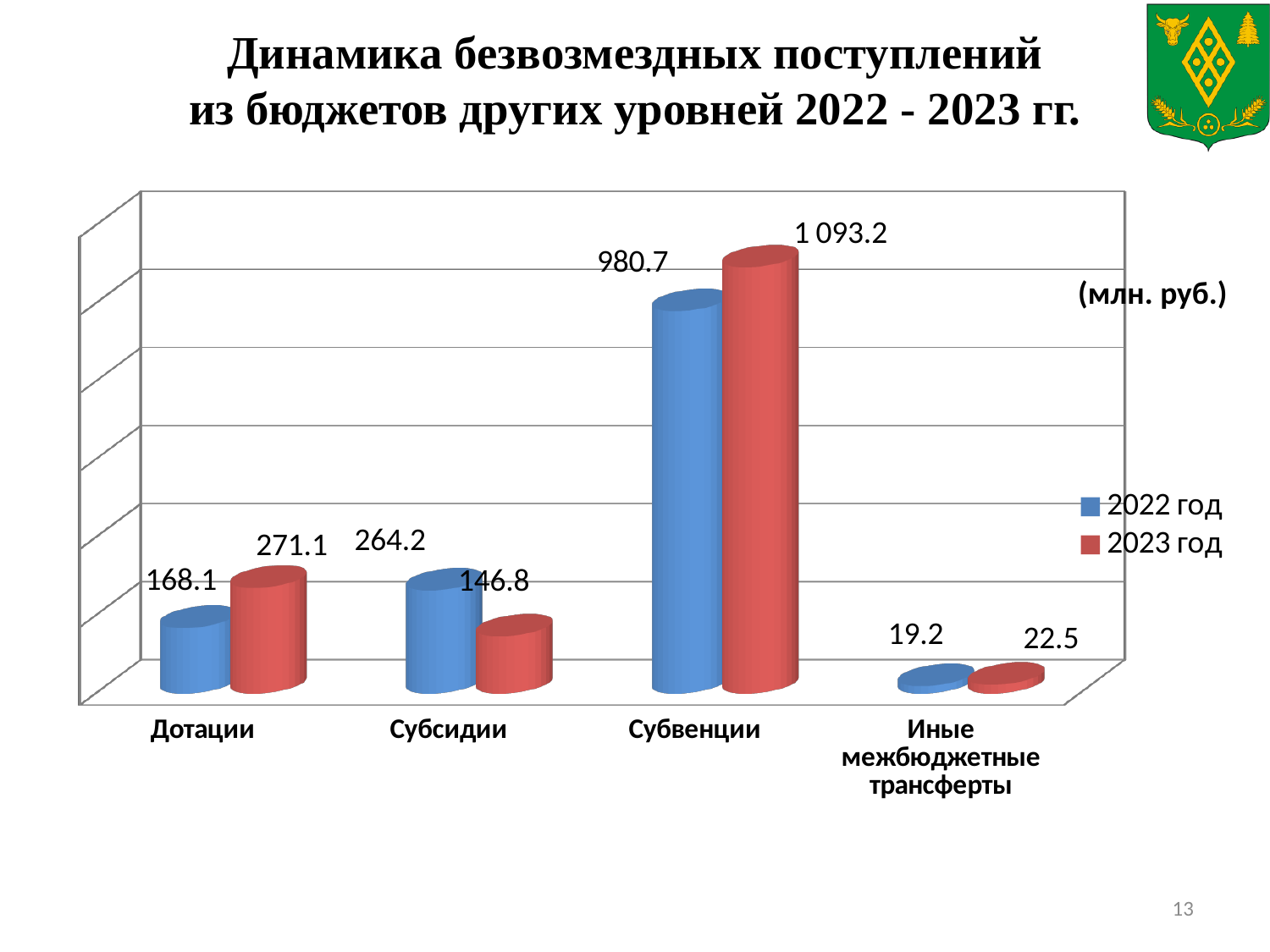
What kind of chart is shown on the slide? bar chart What unit of measurement is indicated on the chart? млн. руб. What is the difference between the 2023 год and 2022 год values for Дотации? 103 What is the difference between the 2022 год and 2023 год values for Субсидии? 117.4 How many series does the legend list? 2 For Субсидии, which series has the larger value, 2022 год or 2023 год? 2022 год Which category has the lowest value in the 2022 год series? Иные межбюджетные трансферты How many categories are shown on the x axis? 4 Which category has the highest value in the 2023 год series? Субвенции What is the value for Иные межбюджетные трансферты in the 2022 год series? 19.2 What is the value for Субвенции in the 2023 год series? 1 093.2 What is the value for Дотации in the 2022 год series? 168.1